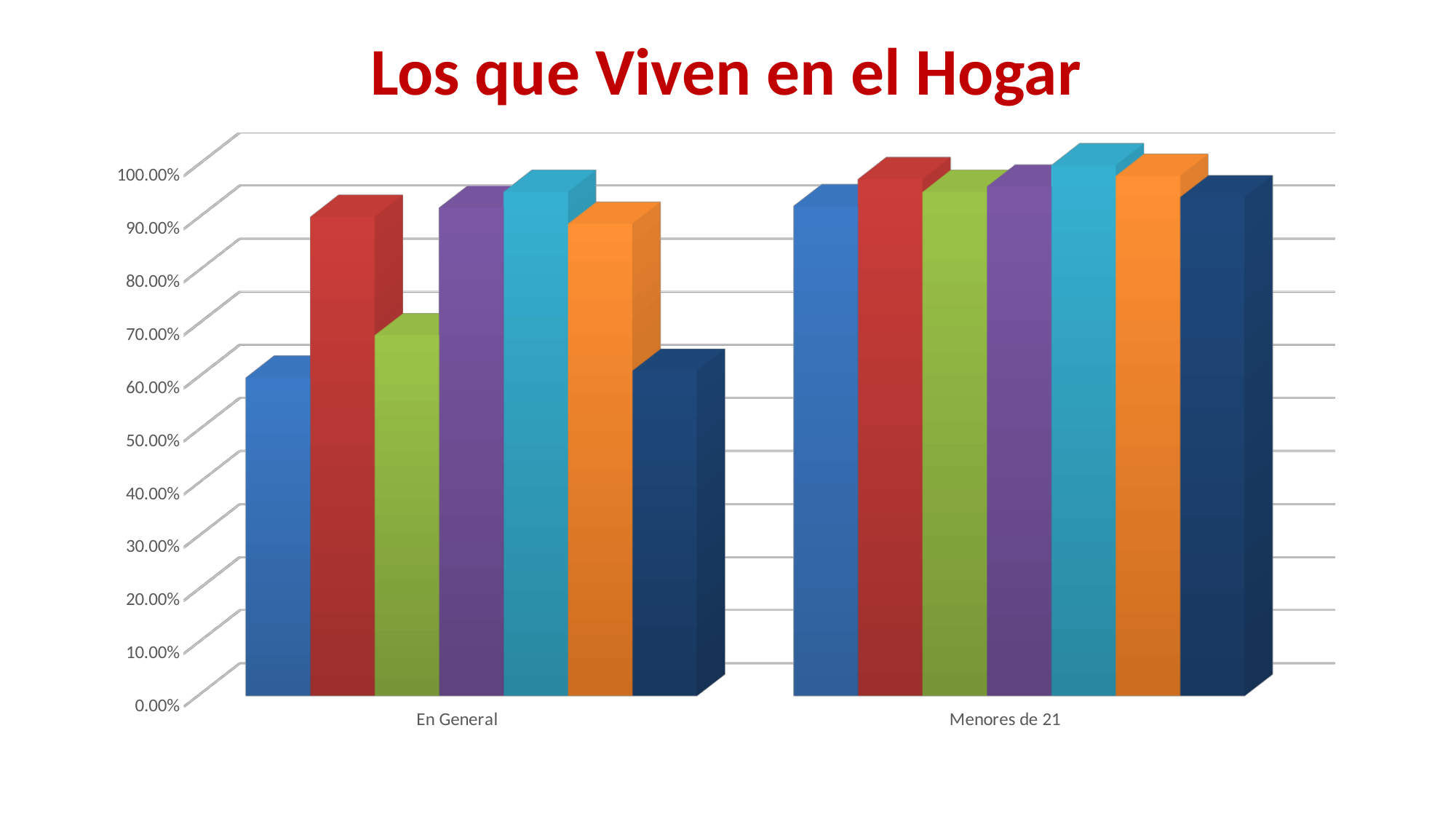
Which bar is the highest in the "En General" group? the light blue (fifth) bar What kind of chart is shown on the slide? bar chart Is the value of the blue (first) bar for "En General" greater or less than 80%? less For "En General", which is larger: the red bar or the green bar? the red bar How many categories are shown on the x axis? 2 What is the title of the chart? Los que Viven en el Hogar Is the value of the light blue (fifth) bar for "Menores de 21" greater or less than 80%? greater Are the bars generally higher for "En General" or for "Menores de 21"? Menores de 21 For "En General", which is larger: the light blue (fifth) bar or the dark blue (last) bar? the light blue bar Is the value of the red (second) bar for "En General" greater or less than 70%? greater How many bars are plotted for the "En General" category? 7